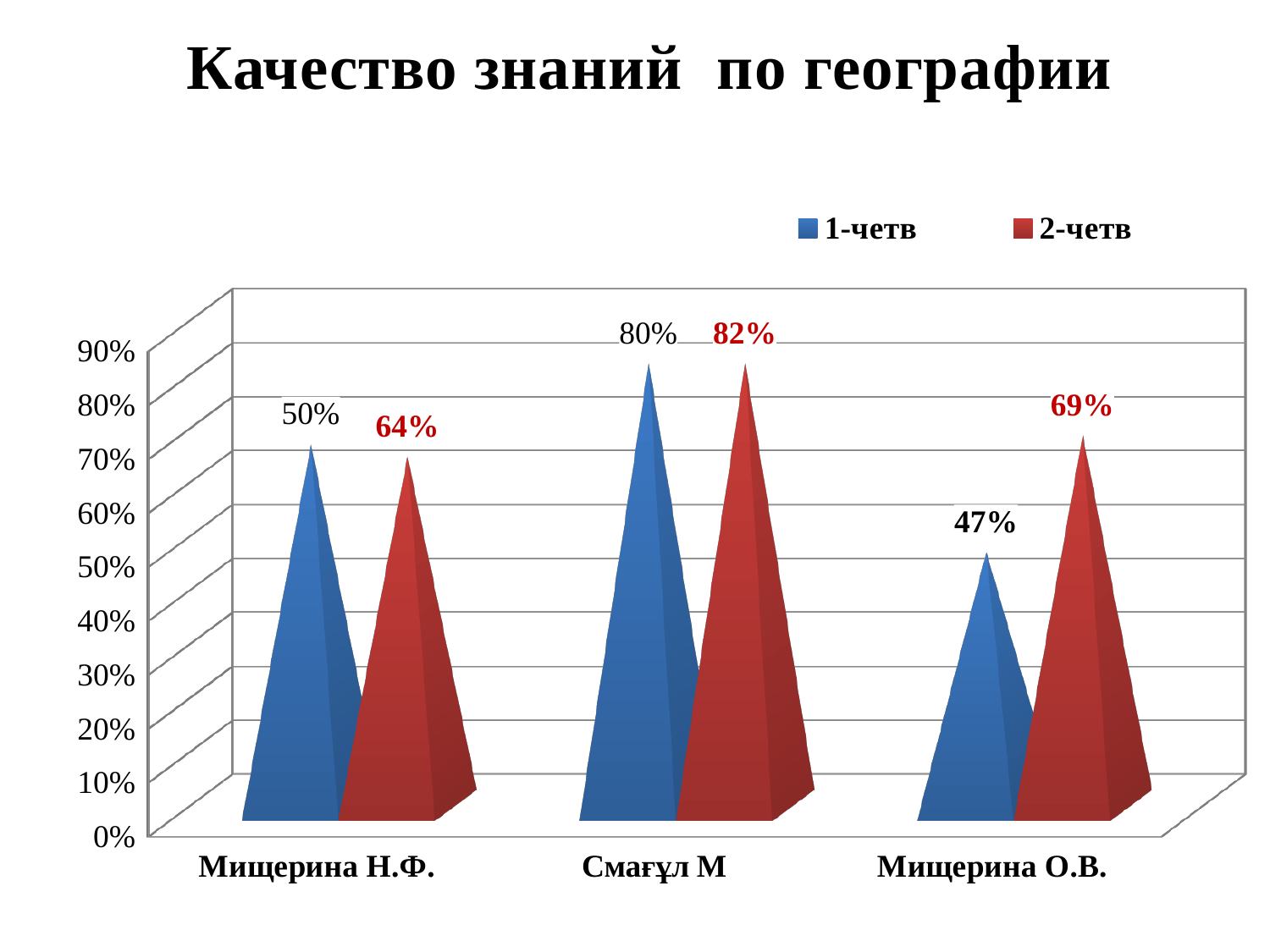
What is the value for Мищерина О.В. in the 2-четв series? 69% What is the difference between the 2-четв and 1-четв values for Мищерина Н.Ф.? 14% What is the value for Мищерина Н.Ф. in the 1-четв series? 50% How many categories are shown on the x axis? 3 What is the value for Смағұл М in the 2-четв series? 82% Which is larger for Смағұл М: the 1-четв value or the 2-четв value? 2-четв What is the difference between the 2-четв and 1-четв values for Мищерина О.В.? 22% How many series does the legend list? 2 What is the title of the chart? Качество знаний по географии Which category has the highest value in the 2-четв series? Смағұл М Which category has the lowest value in the 1-четв series? Мищерина О.В. What is the value for Мищерина О.В. in the 1-четв series? 47%